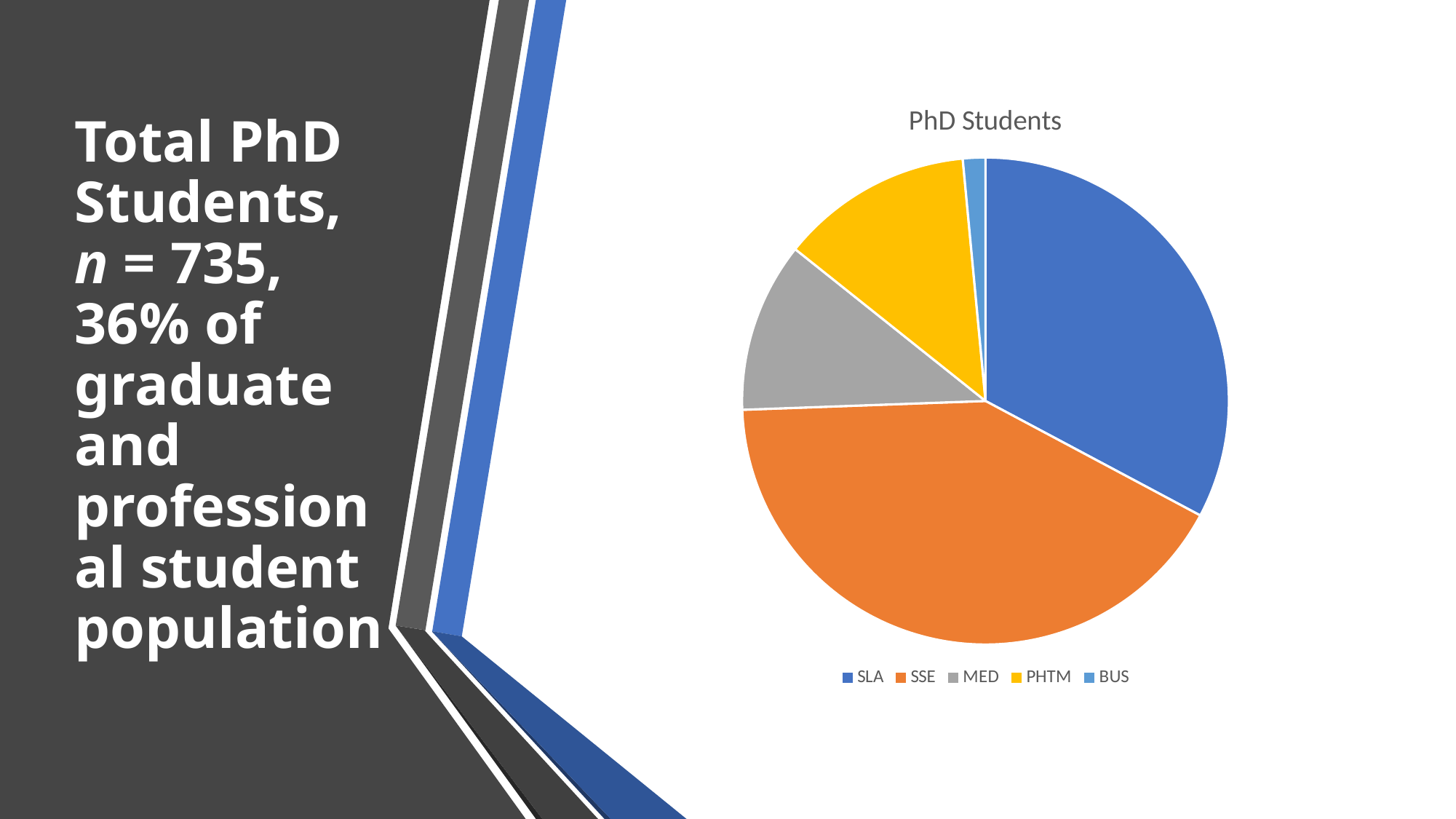
Which slice is larger, SLA or MED? SLA What is the title of the chart? PhD Students Which slice is larger, SSE or PHTM? SSE Which slice is larger, PHTM or BUS? PHTM How many slices does the pie chart have? 5 Which category is shown in orange in the pie chart? SSE What kind of chart is shown on the slide? pie chart Which category has the smallest slice of the pie? BUS Which category has the largest slice of the pie? SSE How many entries does the legend list? 5